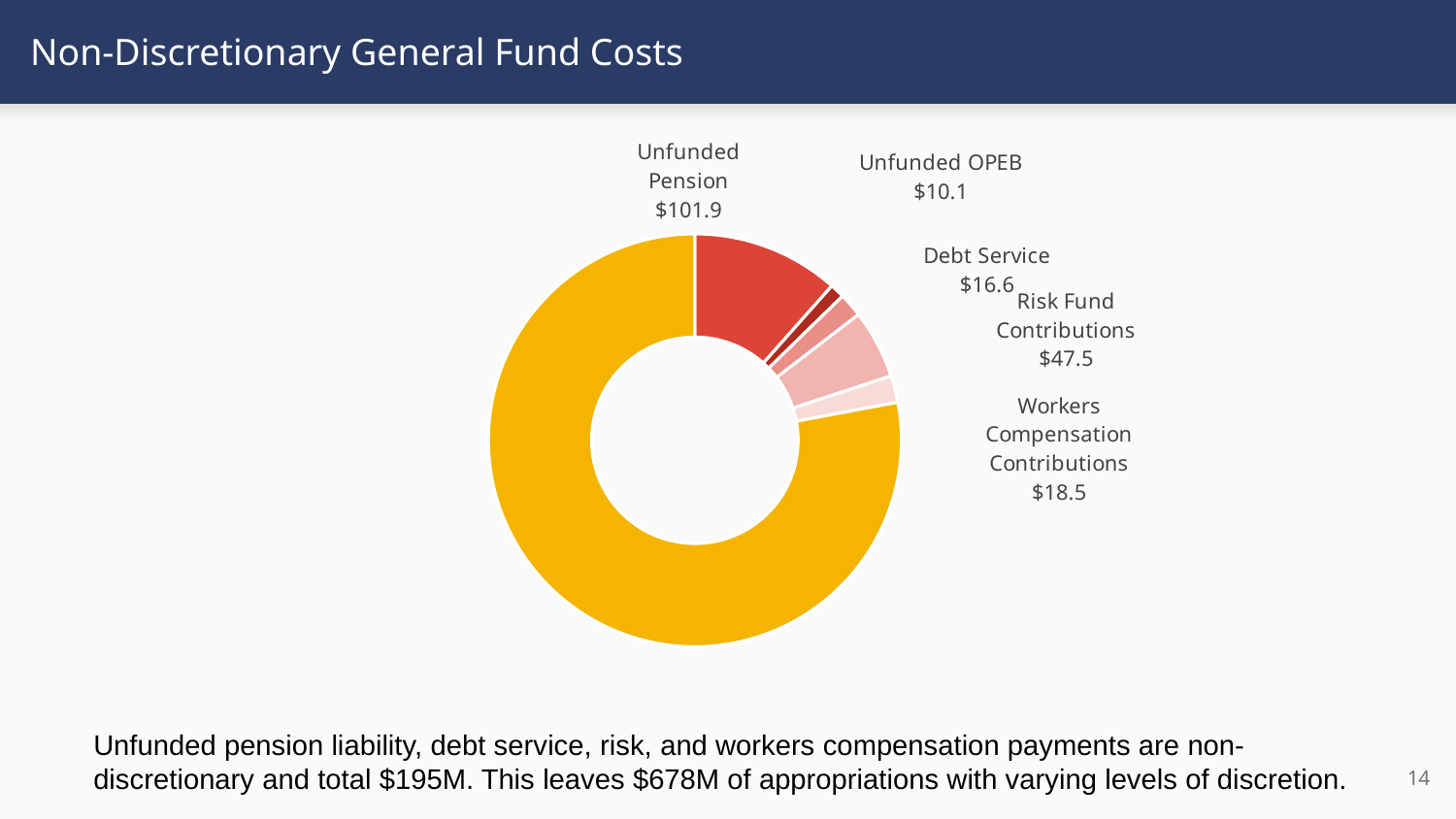
Which is larger, Risk Fund Contributions or Workers Compensation Contributions? Risk Fund Contributions What is the difference between Unfunded Pension and Risk Fund Contributions? $54.4 What is the title of the slide containing the chart? Non-Discretionary General Fund Costs What is the value shown for Risk Fund Contributions? $47.5 What is the value shown for Debt Service? $16.6 Which category has the smallest value? Unfunded OPEB What is the value shown for Workers Compensation Contributions? $18.5 How many categories are shown in the chart? 6 What type of chart is shown on the slide? Pie (donut) chart What is the value shown for Unfunded OPEB? $10.1 What is the value shown for Unfunded Pension? $101.9